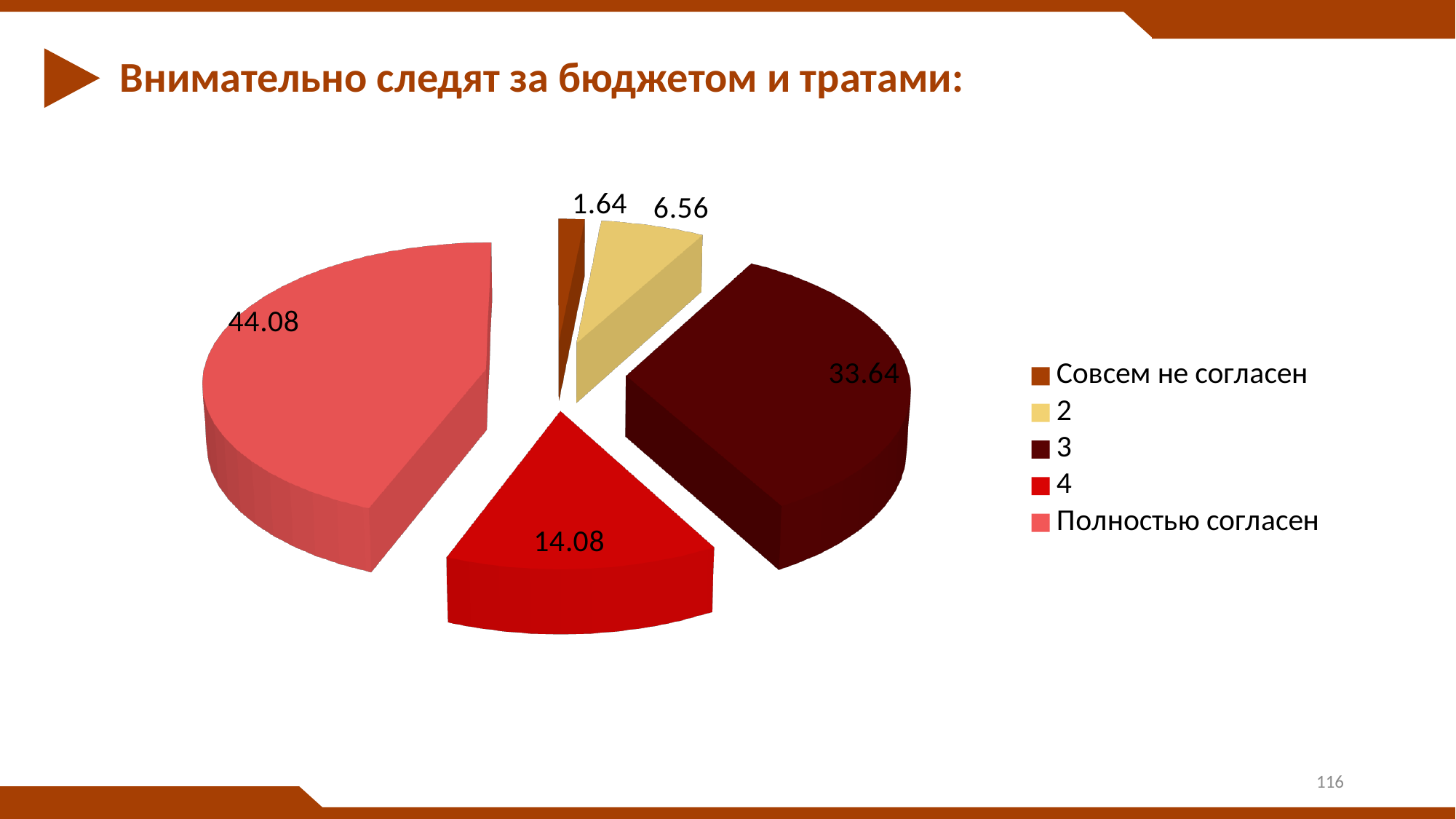
What is the difference between the values for "Полностью согласен" and "3"? 10.44 Which category has the smallest slice of the pie? Совсем не согласен What value is shown for the slice labelled "4"? 14.08 How many slices does the pie chart have? 5 Which category has the largest slice of the pie? Полностью согласен Which is larger, the value for "4" or the value for "2"? 4 What value is shown for the slice labelled "3"? 33.64 What value is shown for the slice labelled "2"? 6.56 What is the title of the slide containing the chart? Внимательно следят за бюджетом и тратами: What value is shown for the "Полностью согласен" slice? 44.08 What kind of chart is shown on the slide? Pie chart What value is shown for the "Совсем не согласен" slice? 1.64